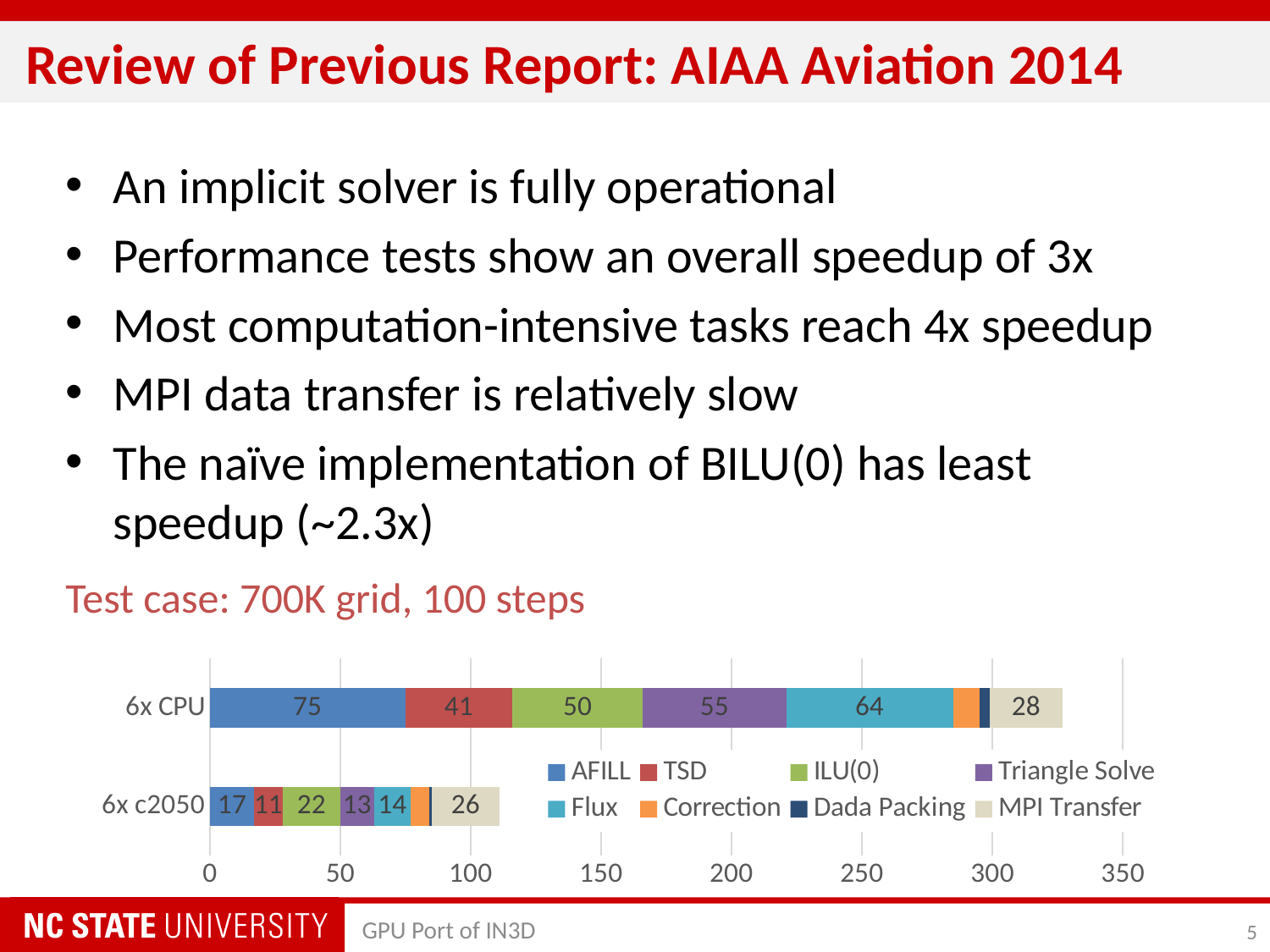
What kind of chart is shown on the slide? stacked bar chart Is the total length of the 6x c2050 bar greater or less than 150? less Is the total length of the 6x CPU bar greater or less than 300? greater Which series is listed last in the chart legend? MPI Transfer How many categories (bars) are plotted in the chart? 2 What is the MPI Transfer value for 6x CPU? 28 What is the AFILL value for 6x CPU? 75 What is the ILU(0) value for 6x c2050? 22 Which category has the larger Triangle Solve value, 6x CPU or 6x c2050? 6x CPU What is the difference between the AFILL values for 6x CPU and 6x c2050? 58 How many series does the chart legend list? 8 What is the Flux value for 6x c2050? 14